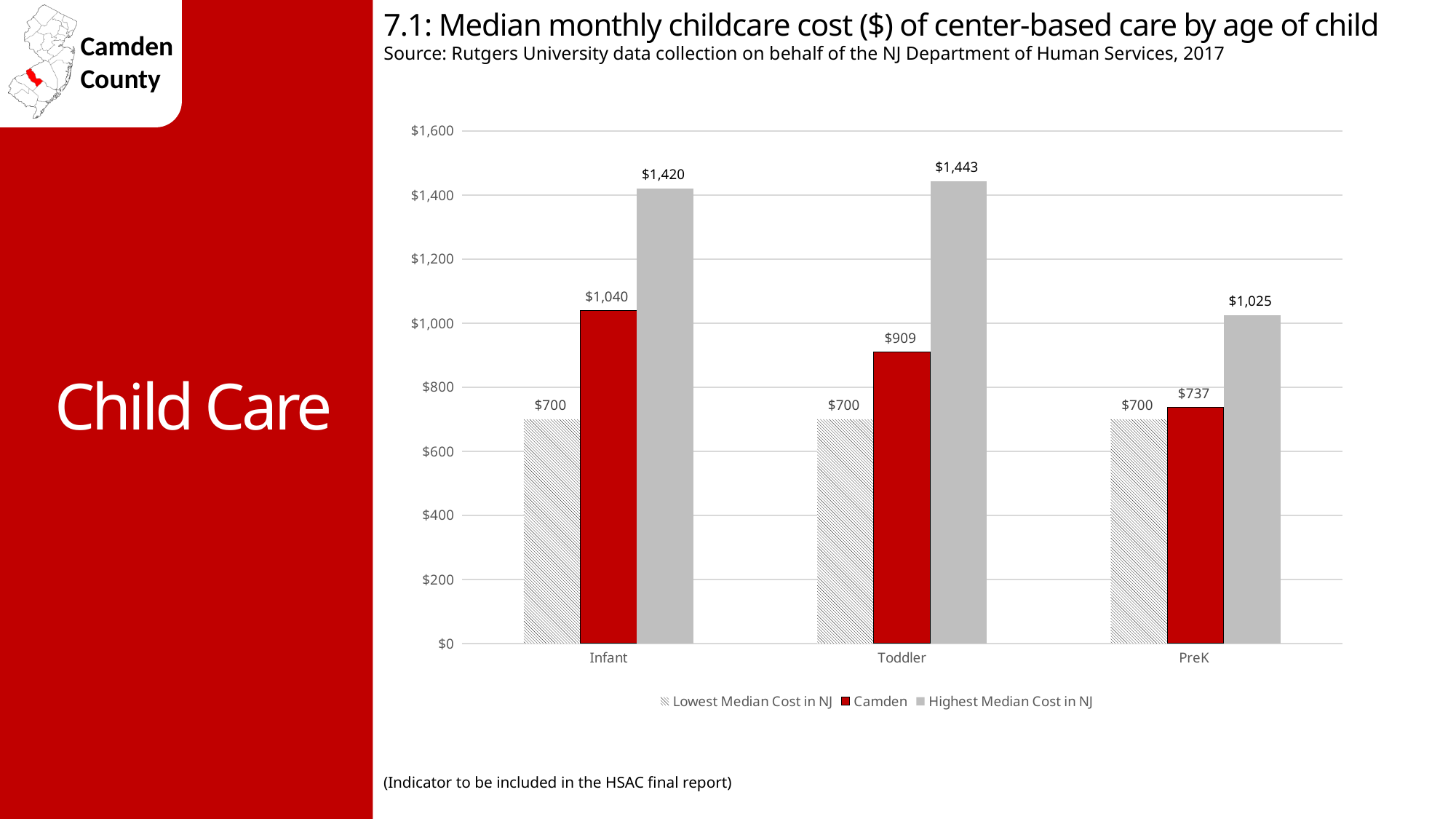
Which is larger: the Camden cost for PreK or the Camden cost for Toddler? Camden cost for Toddler What is the Highest Median Cost in NJ for Toddler care? $1,443 What is the Lowest Median Cost in NJ for PreK care? $700 Is the Camden cost for PreK greater or less than $800? less What kind of chart is shown on the slide? bar chart What is the Camden median monthly childcare cost for Infant care? $1,040 Which series is shown in red? Camden How many series does the legend list? 3 What is the difference between the Highest Median Cost in NJ and the Camden cost for Toddler care? $534 For which age group is the Camden median monthly cost highest? Infant For which age group is the Highest Median Cost in NJ lowest? PreK How many age groups are shown on the x axis? 3